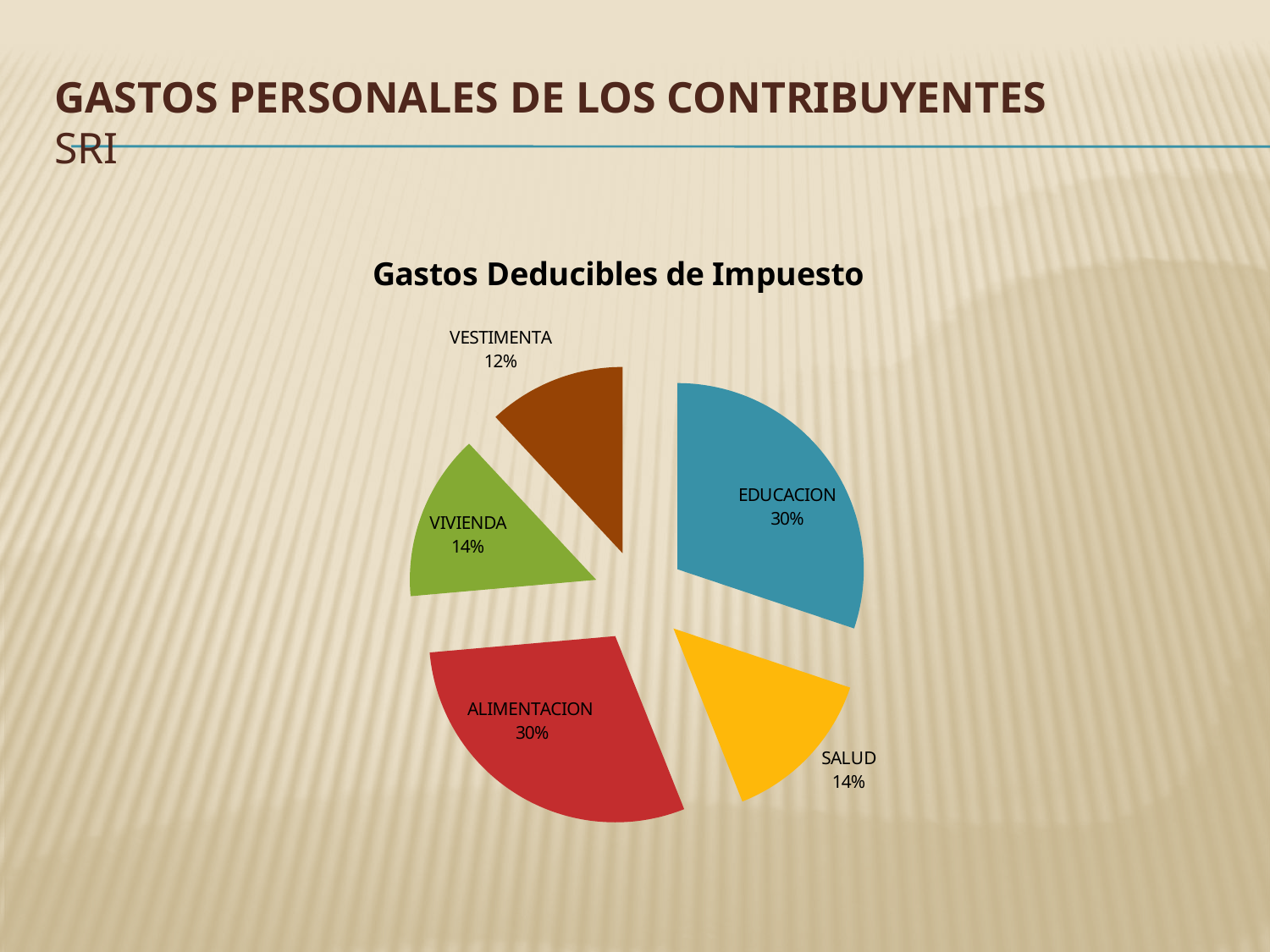
What is the difference between the shares of EDUCACION and VESTIMENTA? 18% What share of the pie does ALIMENTACION represent? 30% What share of the pie does EDUCACION represent? 30% What share of the pie does SALUD represent? 14% What colour is the EDUCACION slice? blue Which category has the smallest slice of the pie? VESTIMENTA How many categories are shown in the pie chart? 5 Which is larger, the share for VIVIENDA or the share for VESTIMENTA? VIVIENDA What is the title of the chart? Gastos Deducibles de Impuesto What kind of chart is shown on the slide? pie chart